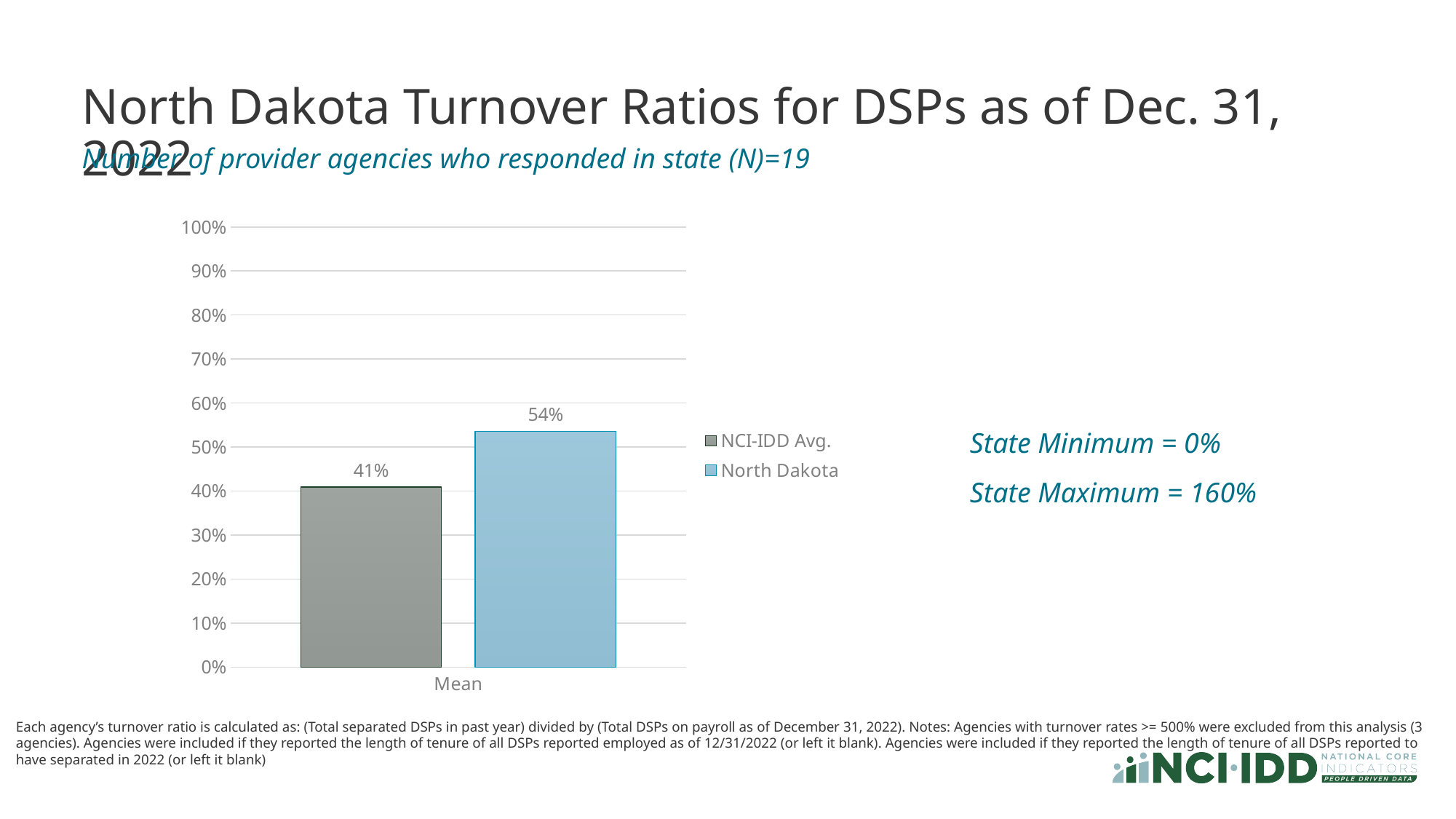
What kind of chart is shown on the slide? Bar chart What is the category label on the x axis of the chart? Mean What is the difference between the North Dakota mean turnover ratio and the NCI-IDD Avg. mean turnover ratio? 13% What is the mean turnover ratio for North Dakota? 54% How many series does the legend list? 2 What is the highest value shown on the y axis of the chart? 100% What is the mean turnover ratio for NCI-IDD Avg.? 41% Is the NCI-IDD Avg. mean turnover ratio greater or less than 50%? less How many categories are shown on the x axis? 1 Which series has the lowest mean turnover ratio? NCI-IDD Avg. Which series has the higher mean turnover ratio, NCI-IDD Avg. or North Dakota? North Dakota Is the North Dakota mean turnover ratio greater or less than 50%? greater